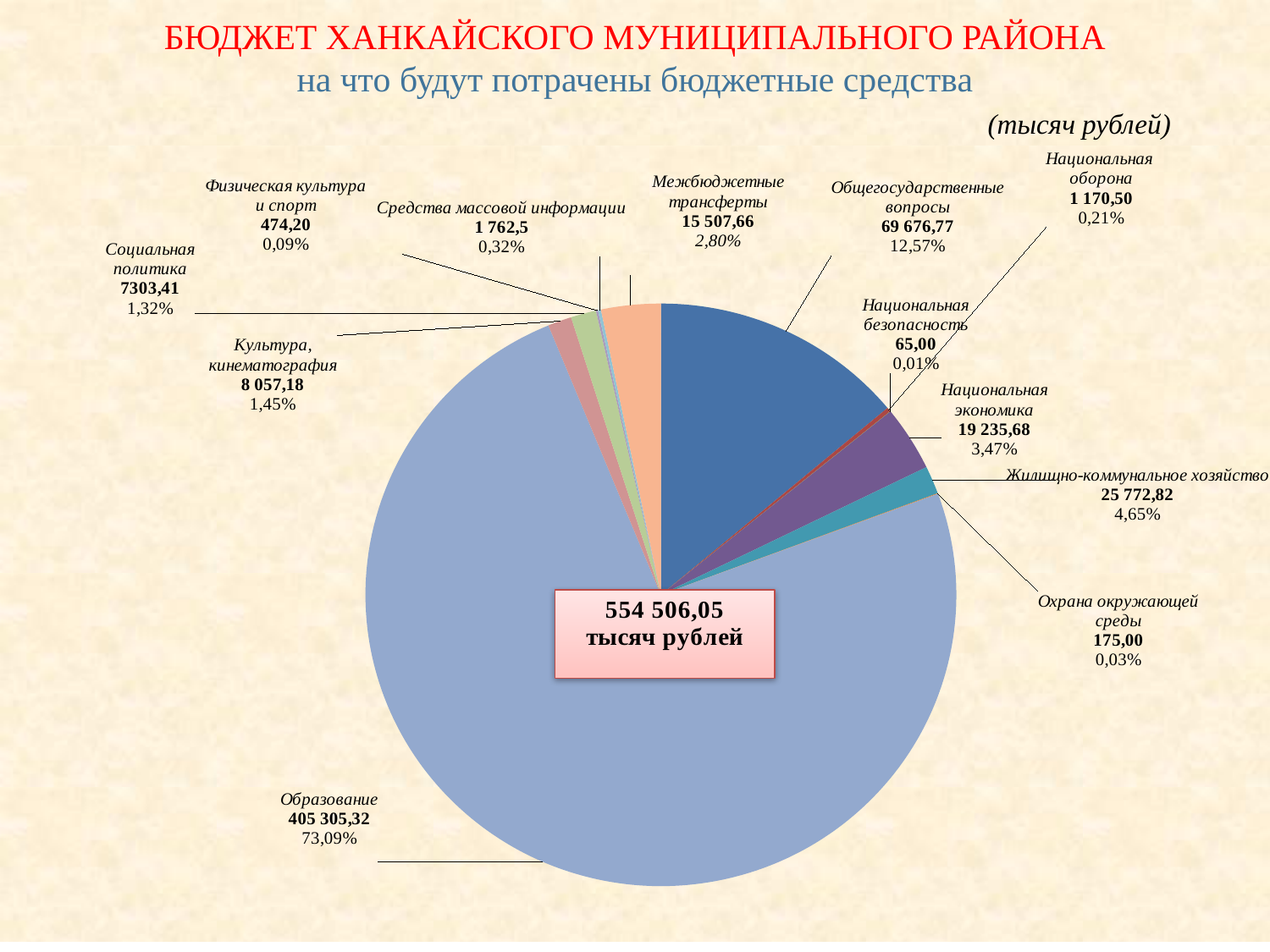
What is the value for Жилищно-коммунальное хозяйство? 25 772,82 How many categories (slices) does the pie chart have? 12 Which category has the smallest slice of the pie? Национальная безопасность Which category has the largest slice of the pie? Образование What is the value for Общегосударственные вопросы? 69 676,77 What share of the pie does Национальная экономика take? 3,47% What total amount is shown in the box at the centre of the pie chart? 554 506,05 тысяч рублей What is the difference between the values for Общегосударственные вопросы and Национальная экономика? 50 441,09 Which is larger, the value for Межбюджетные трансферты or the value for Культура, кинематография? Межбюджетные трансферты What is the value for Образование? 405 305,32 What kind of chart is shown on the slide? pie chart What share of the pie does Образование take? 73,09%